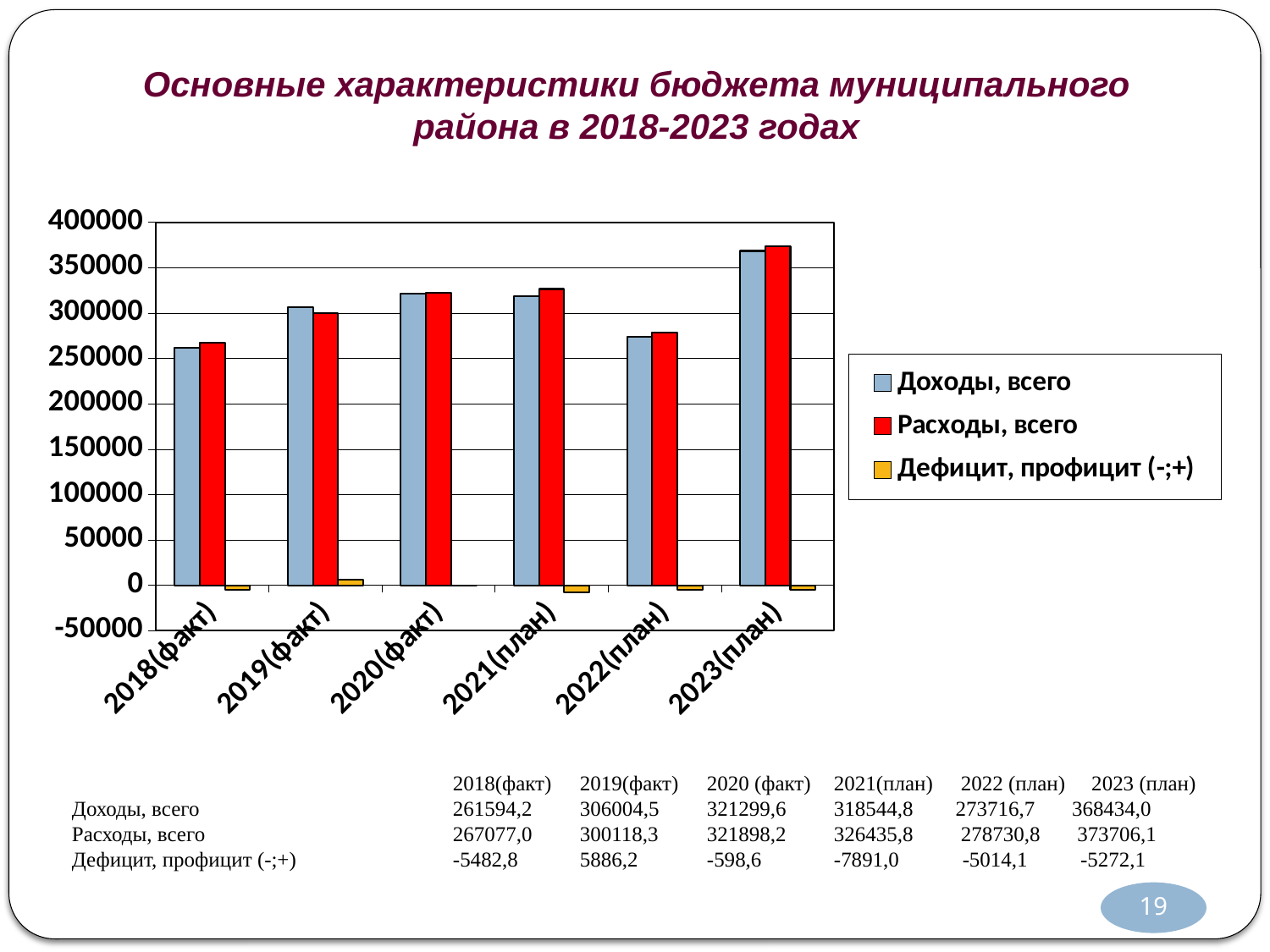
How many years are shown on the x axis of the chart? 6 What colour represents Расходы, всего in the legend? red Is the value of Доходы, всего for 2022(план) greater or less than 300000? less How many series does the legend list? 3 What is the difference between Расходы, всего and Доходы, всего in 2023(план)? 5272,1 What kind of chart is shown on the slide? bar chart What is the value of Доходы, всего for 2018(факт)? 261594,2 What is the value of Дефицит, профицит (-;+) for 2019(факт)? 5886,2 What is the value of Расходы, всего for 2021(план)? 326435,8 Which year has the lowest value of Расходы, всего? 2018(факт) Which year has the highest value of Доходы, всего? 2023(план) In 2021(план), which is larger: Доходы, всего or Расходы, всего? Расходы, всего